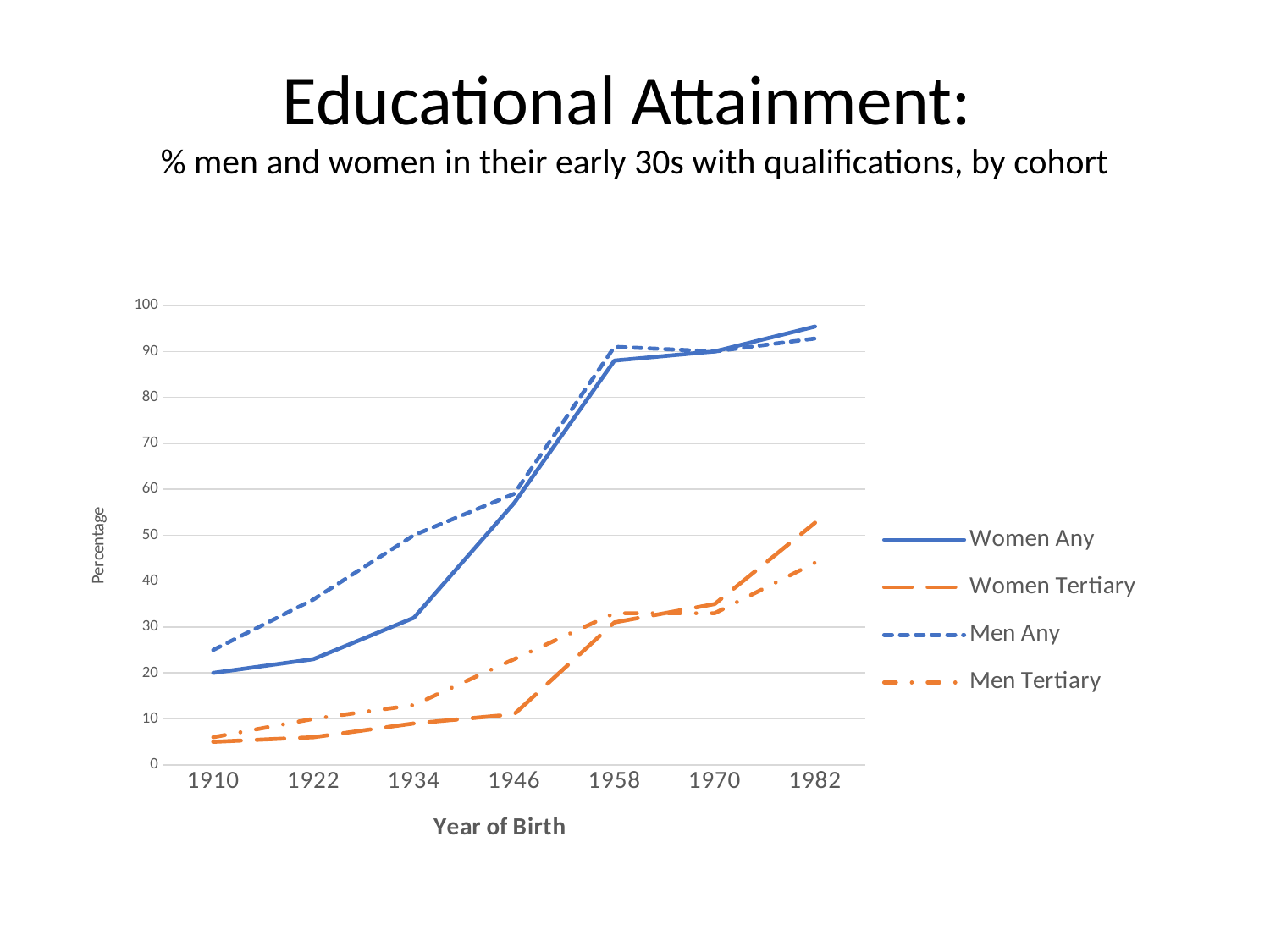
In 1982, which is larger: Women Tertiary or Men Tertiary? Women Tertiary Is the value for Women Any in 1982 greater or less than 90? greater Is the value for Women Tertiary in 1982 greater or less than 50? greater Is the value for Men Any in 1934 greater or less than 40? greater What kind of chart is shown on the slide? line chart How many series does the legend list? 4 How many birth-year cohorts are plotted along the x axis? 7 Which series has the lowest value in 1946? Women Tertiary In 1934, which is larger: Men Any or Women Any? Men Any Does the Women Any series rise or fall from 1910 to 1982? rise